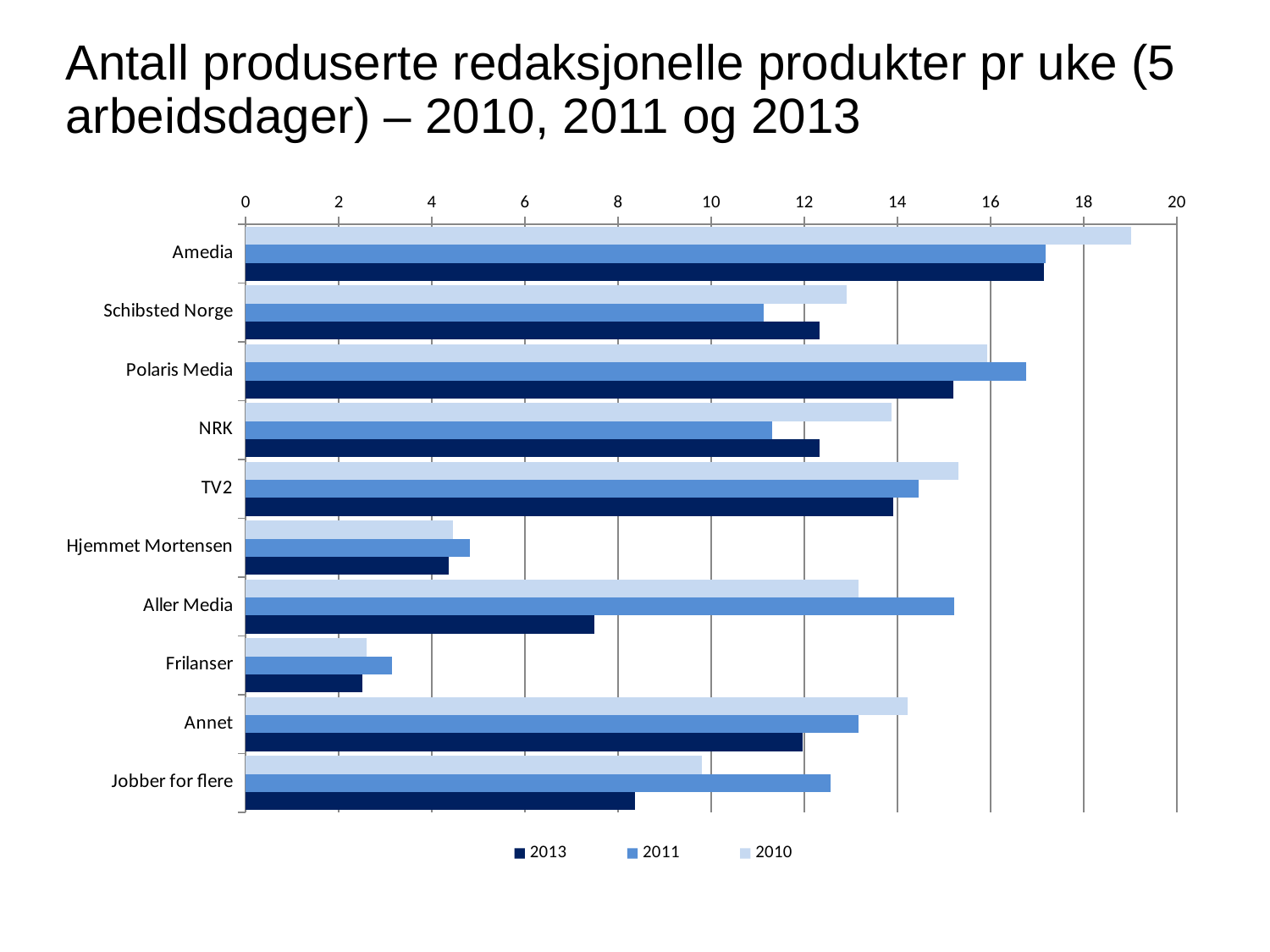
Is the 2013 value for Jobber for flere greater or less than 10? less For Aller Media, which is larger: the 2011 value or the 2013 value? 2011 How many series does the legend list? 3 Which category has the highest value for 2010? Amedia For 2011, which is larger: Polaris Media or TV2? Polaris Media Which category has the lowest value for 2013? Frilanser Is the 2010 value for Amedia greater or less than 18? greater Is the 2013 value for Aller Media greater or less than 8? less Which years are listed in the chart's legend? 2013, 2011 and 2010 What kind of chart is shown on the slide? Bar chart How many categories are listed on the vertical axis of the chart? 10 Which category has the lowest value for 2010? Frilanser